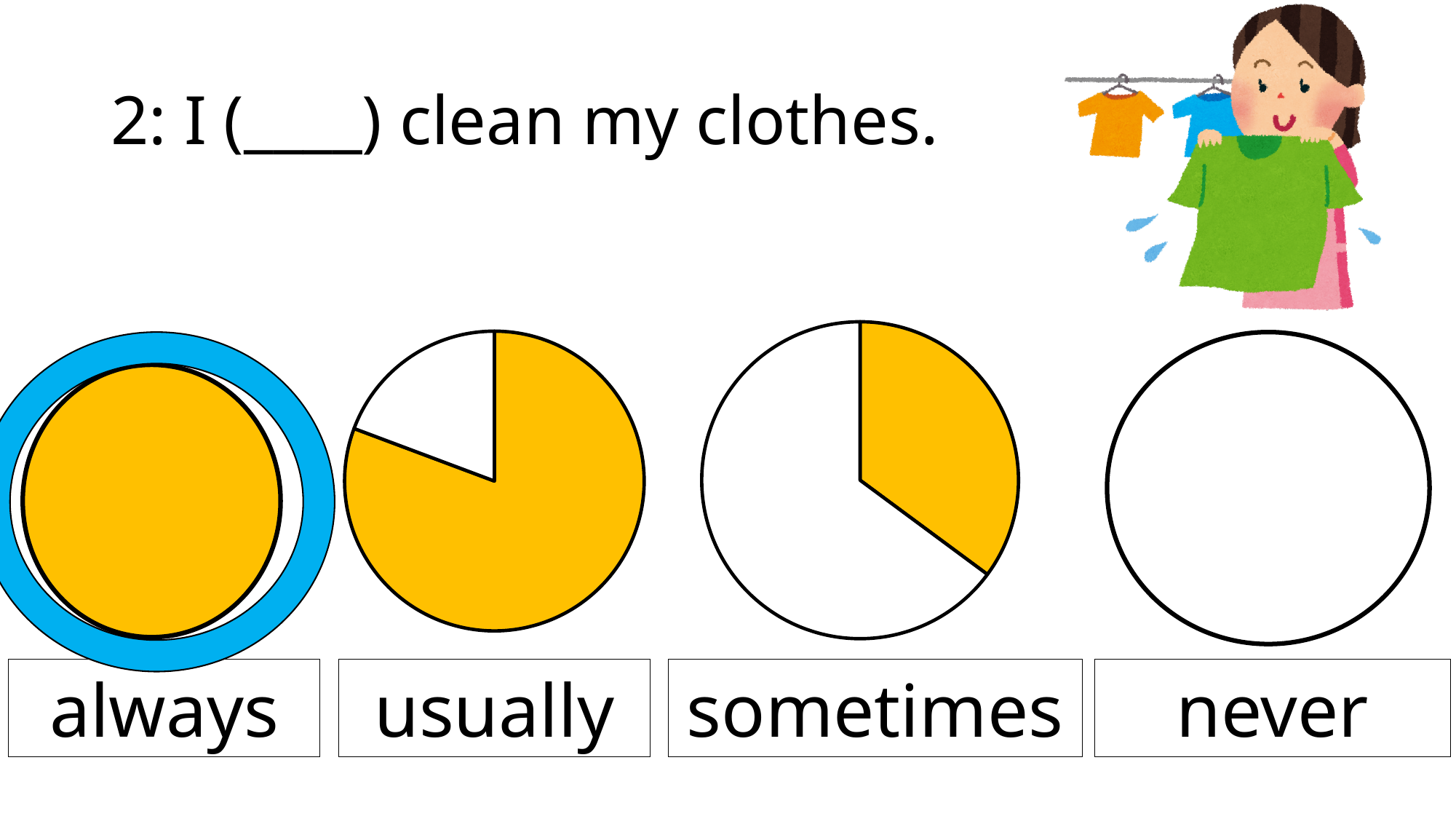
What kind of chart is used to show each frequency word on the slide? pie chart Which pie chart has a larger filled portion, the one labelled usually or the one labelled sometimes? usually What colour is used for the filled portion of the pie charts? yellow Which pie chart has a larger filled portion, the one labelled sometimes or the one labelled never? sometimes How many pie charts are shown on the slide? 4 Do the filled portions of the pie charts increase or decrease from left to right across the slide? decrease Which pie chart has the largest filled (yellow) portion? always Is the filled share of the pie chart labelled sometimes greater or less than 50%? less Which pie chart has the smallest filled (yellow) portion? never Which pie chart is circled in blue on the slide? always Is the filled share of the pie chart labelled usually greater or less than 50%? greater